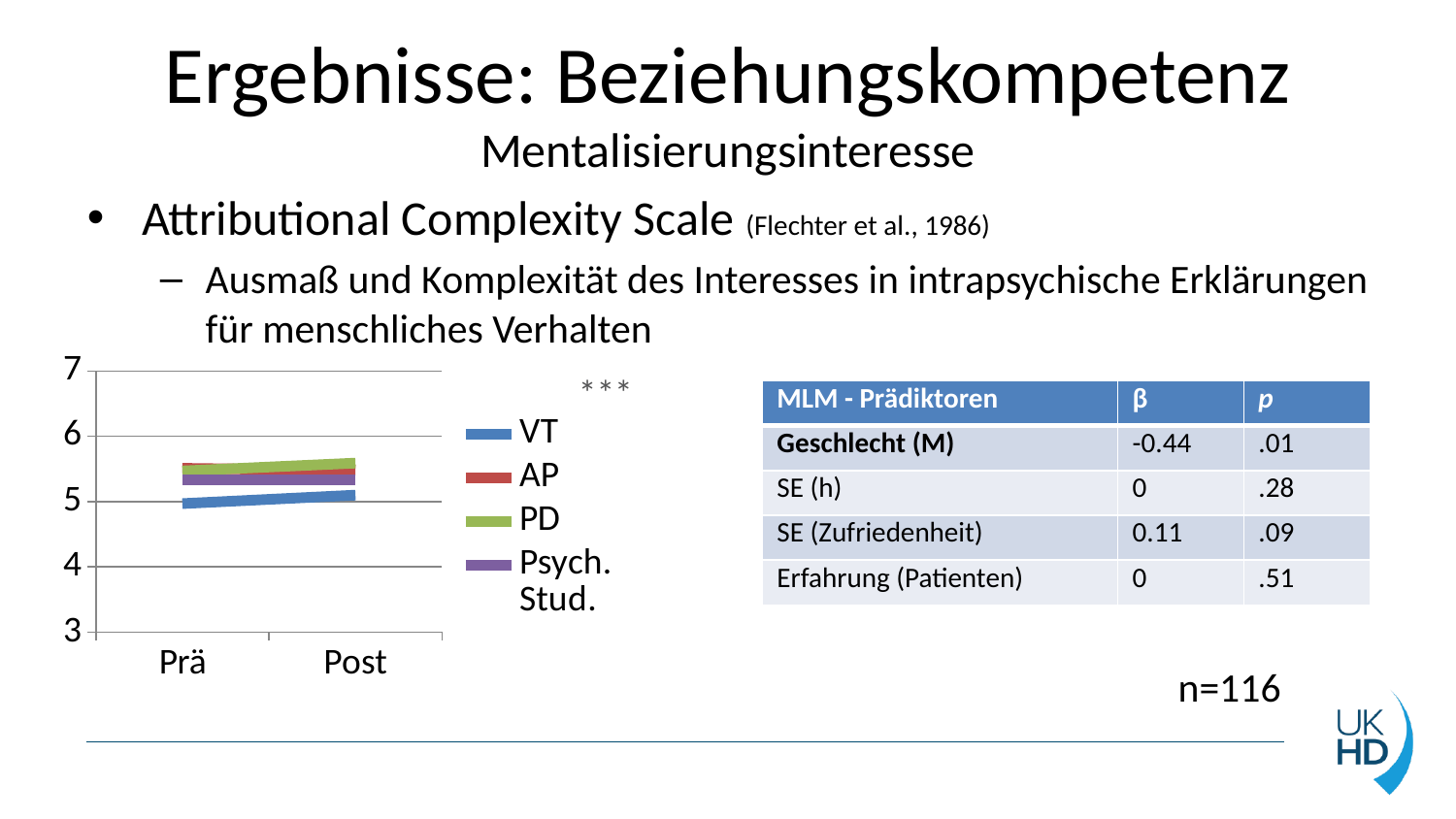
Which series has the lowest value at Post? VT What is the highest value shown on the chart's y axis? 7 Does the VT line rise or fall from Prä to Post? rise Which is larger at Post, the value for VT or the value for PD? PD What kind of chart is shown on the slide? line chart How many series does the chart legend list? 4 What are the two labels on the x axis of the chart? Prä, Post How many time points are shown on the x axis of the chart? 2 Is the value for PD at Post greater or less than 5? greater Is the value for AP at Prä greater or less than 4? greater Is the value for VT at Prä greater or less than 6? less Which series has the lowest value at Prä? VT